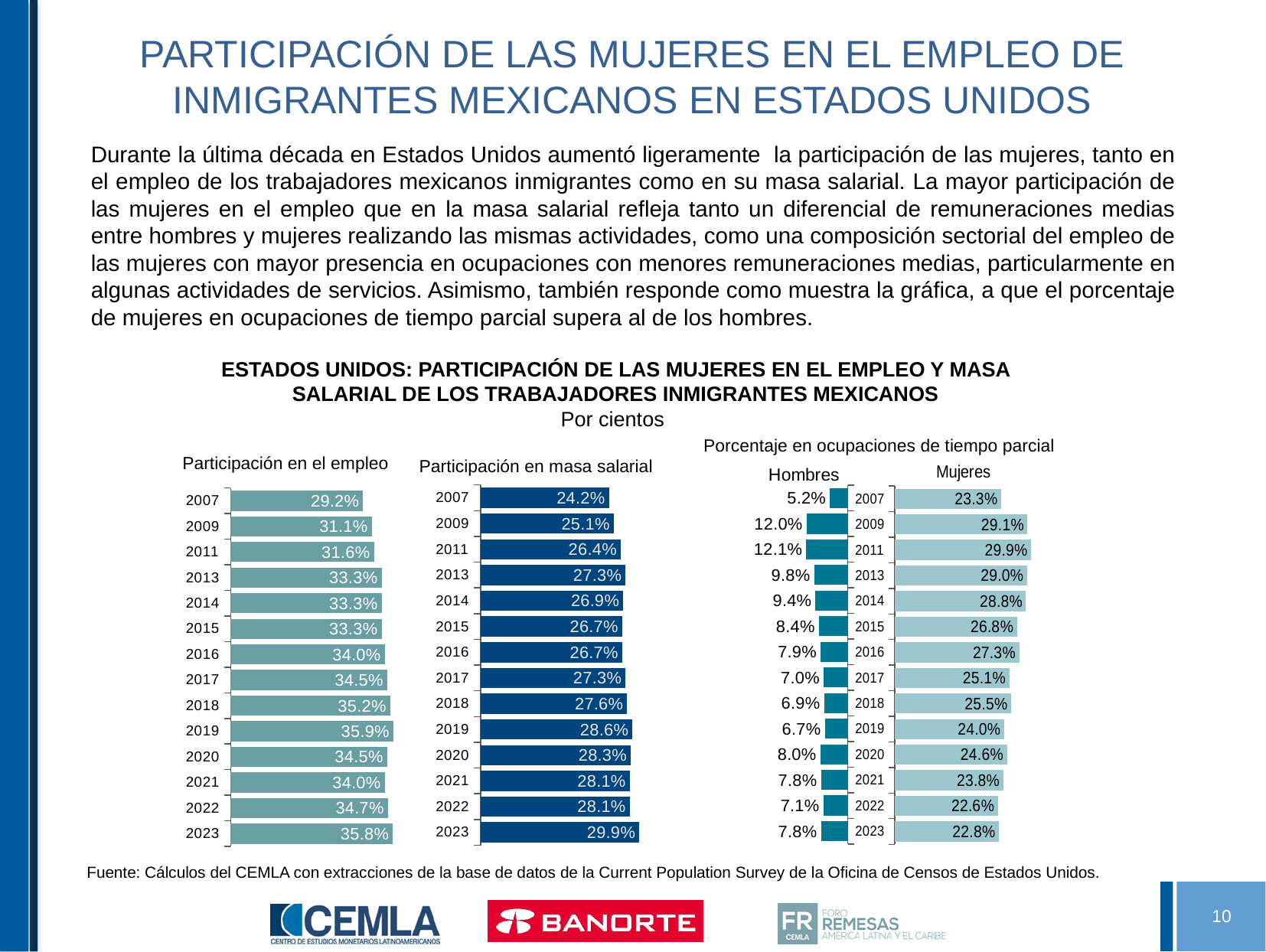
In the 'Porcentaje en ocupaciones de tiempo parcial' chart, what is the value for Hombres in 2011? 12.1% In the 'Participación en masa salarial' chart, which year has the lowest value? 2007 In the 'Participación en masa salarial' chart, what is the value for 2019? 28.6% In the 'Participación en masa salarial' chart, do the values generally rise or fall from 2007 to 2023? Rise How many years are shown in the 'Participación en el empleo' chart? 14 In the 'Participación en el empleo' chart, what is the value for 2023? 35.8% What kind of chart is the 'Participación en masa salarial' chart? Bar chart In the 'Porcentaje en ocupaciones de tiempo parcial' chart, what is the value for Mujeres in 2007? 23.3% In the 'Participación en el empleo' chart, which year has the highest value? 2019 Which is larger for 2023: the value in the 'Participación en el empleo' chart or the value in the 'Participación en masa salarial' chart? Participación en el empleo In the 'Porcentaje en ocupaciones de tiempo parcial' chart, what is the difference between the Mujeres and Hombres values for 2023? 15.0 percentage points In the 'Porcentaje en ocupaciones de tiempo parcial' chart, which year has the lowest value for Mujeres? 2022